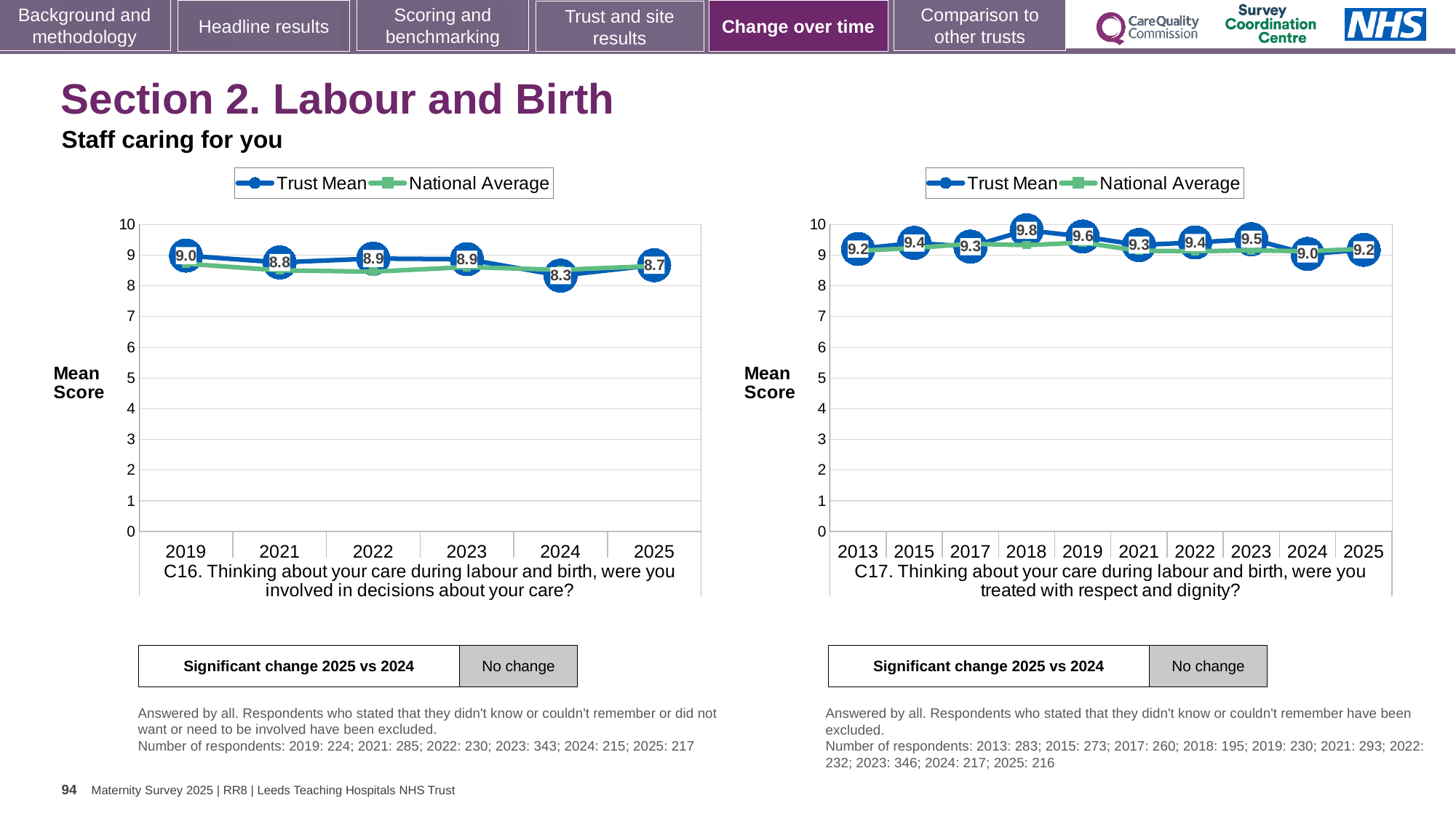
On the right chart (C17), how many years are plotted on the x axis? 10 On the right chart (C17), which year has the lowest Trust Mean score? 2024 On the left chart (C16), what is the Trust Mean score for 2019? 9.0 How many series does the legend of the right chart (C17) list? 2 On the left chart (C16), which year has the lowest Trust Mean score? 2024 On the left chart (C16), what is the difference between the Trust Mean scores for 2019 and 2024? 0.7 On the left chart (C16), what is the Trust Mean score for 2024? 8.3 On the right chart (C17), which year has the highest Trust Mean score? 2018 On the left chart (C16), how many years are plotted on the x axis? 6 On the right chart (C17), is the Trust Mean score for 2025 larger or smaller than the score for 2024? larger What kind of chart is the left chart (C16)? Line chart On the right chart (C17), what is the Trust Mean score for 2018? 9.8